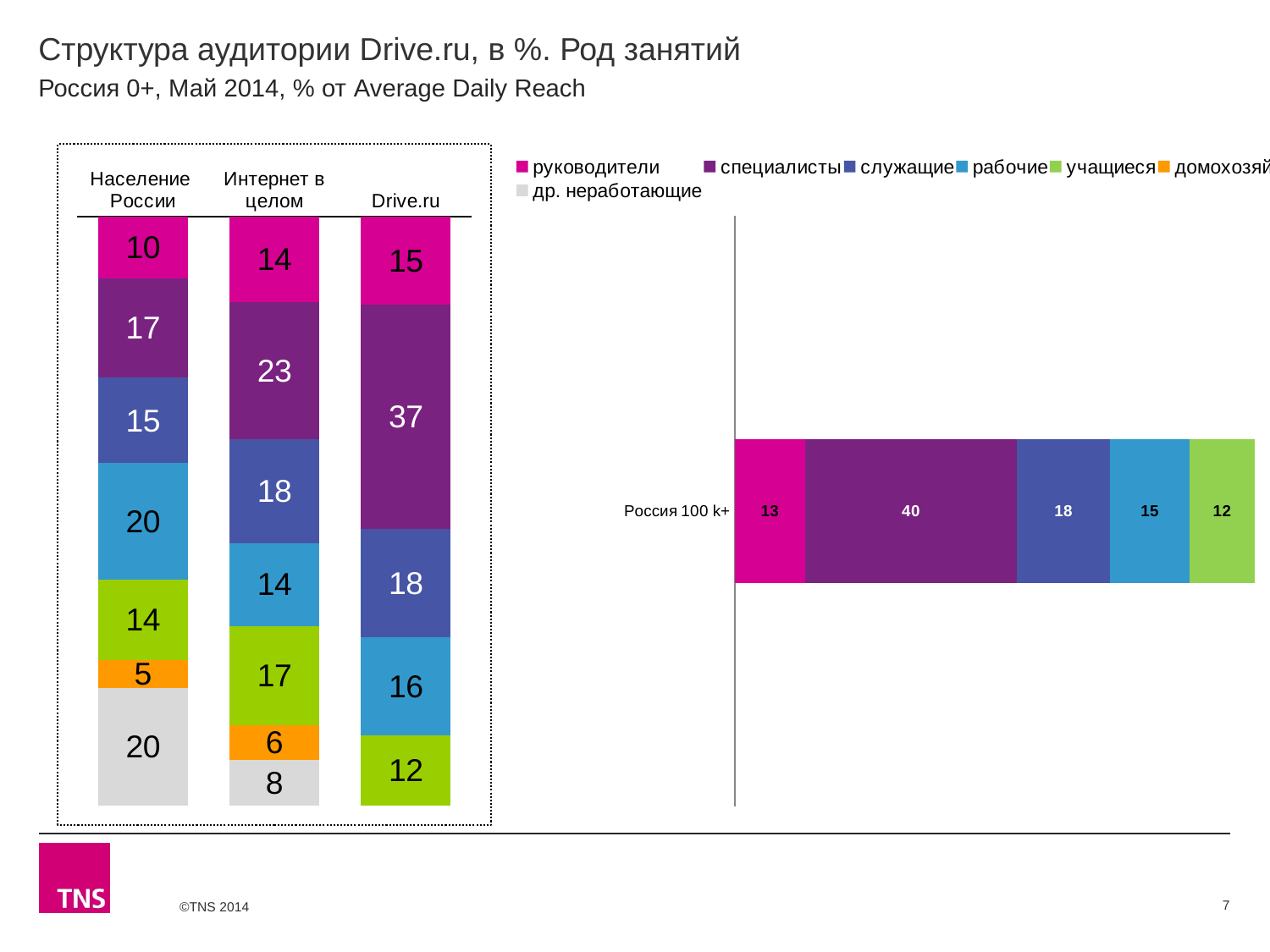
In the right chart (Россия 100 k+), what is the value for специалисты? 40 What kind of chart is the right chart (Россия 100 k+)? stacked bar chart In the left chart, what is the value for домохозяйки in the Интернет в целом bar? 6 In the right chart (Россия 100 k+), which category has the smallest segment? учащиеся In the left chart, what is the difference between the специалисты values for Drive.ru and Интернет в целом? 14 In the left chart, what is the value for специалисты in the Drive.ru bar? 37 How many stacked bars are shown in the left chart? 3 In the left chart, which category has the largest segment in the Drive.ru bar? специалисты How many categories does the legend list? 7 In the left chart, which bar has the larger руководители value: Drive.ru or Население России? Drive.ru In the left chart, what is the value for рабочие in the Население России bar? 20 In the right chart (Россия 100 k+), what is the total of all the labelled segments? 98